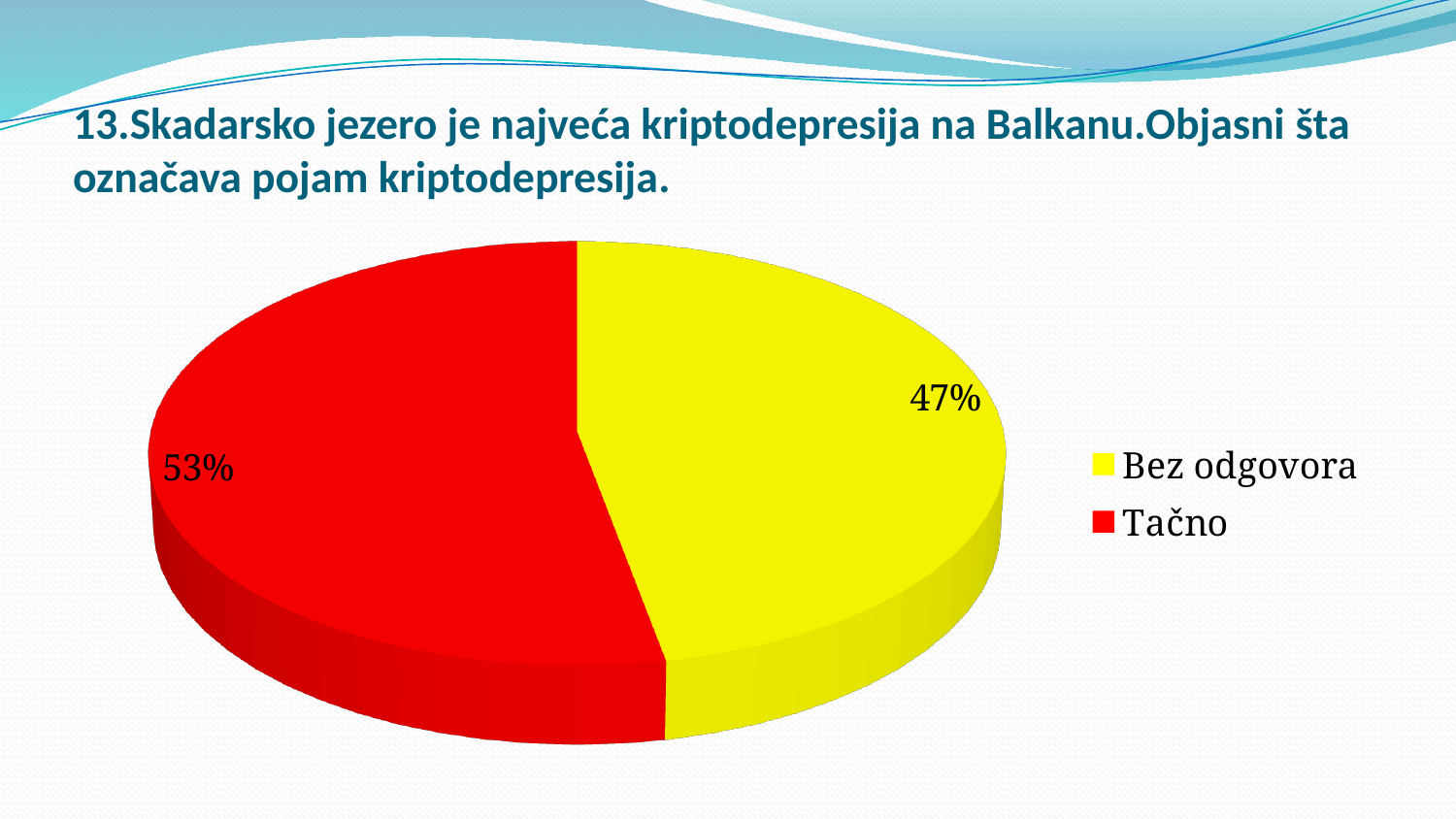
What colour is the "Tačno" slice? red What is the share of the pie taken by the "Bez odgovora" slice? 47% Which category has the smallest share of the pie? Bez odgovora What percentage of the pie is labelled "Bez odgovora"? 47% Which slice is larger, "Tačno" or "Bez odgovora"? Tačno What kind of chart is shown on the slide? pie chart How many slices does the pie chart have? 2 What colour is the "Bez odgovora" slice? yellow What is the difference in percentage points between the "Tačno" and "Bez odgovora" slices? 6 How many entries does the legend list? 2 What percentage of the pie is labelled "Tačno"? 53% Which category has the largest share of the pie? Tačno